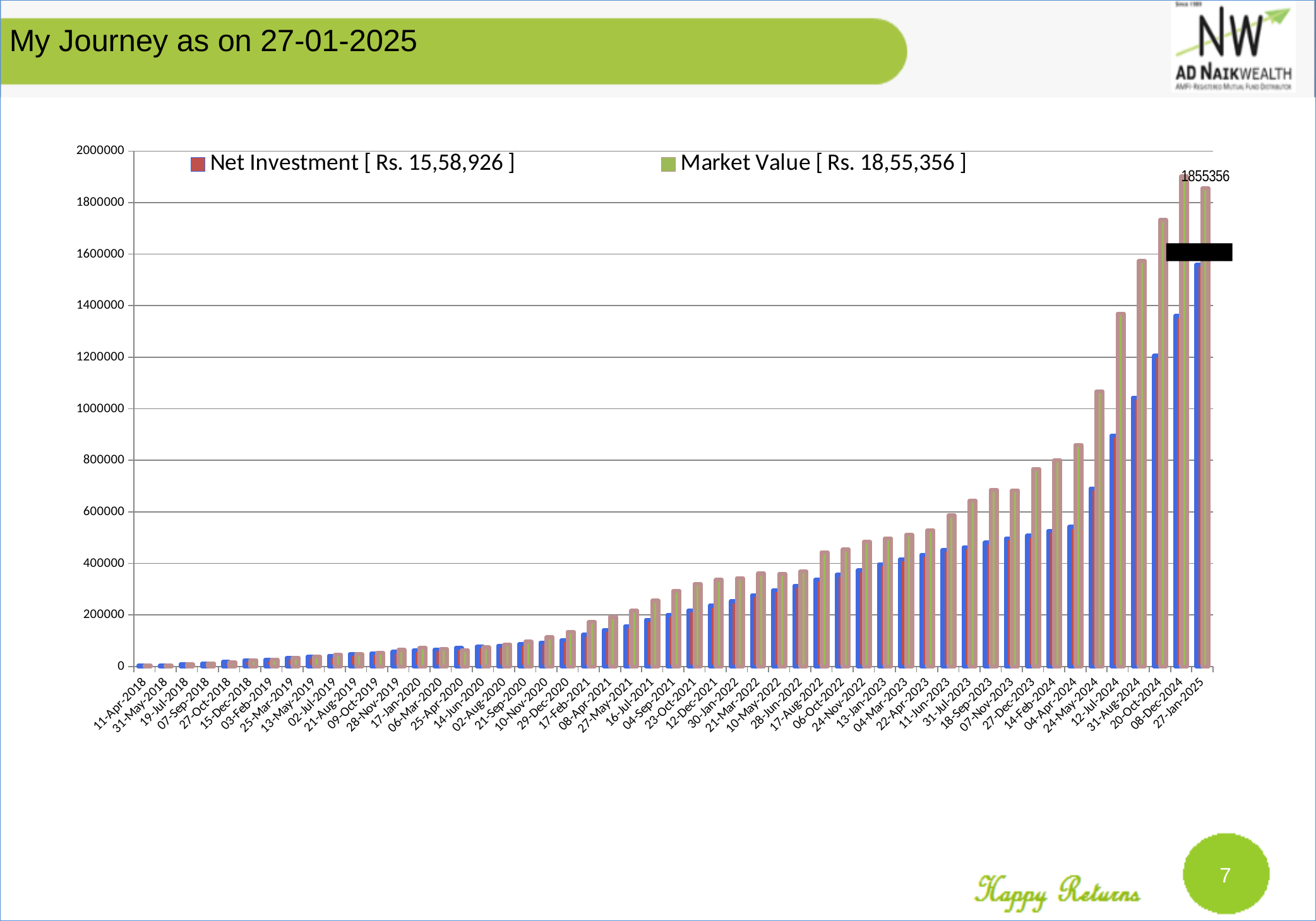
Is the Market Value for 08-Dec-2024 greater or less than 1800000? greater How many series does the chart legend list? 2 Is the Market Value for 12-Jul-2024 greater or less than 1200000? greater What is the title of the slide containing the chart? My Journey as on 27-01-2025 According to the legend, what is the Market Value amount? Rs. 18,55,356 What is the difference between the Market Value (Rs. 18,55,356) and the Net Investment (Rs. 15,58,926) shown in the legend? Rs. 2,96,430 According to the legend, what is the Net Investment amount? Rs. 15,58,926 What type of chart is shown on the slide? Bar chart Which is larger as of 27-Jan-2025, the Net Investment or the Market Value? Market Value What is the data label shown on the Market Value bar for 27-Jan-2025? 1855356 Do the Market Value bars generally rise or fall from left to right along the x axis? Rise Is the Market Value for 27-Dec-2023 greater or less than 800000? less